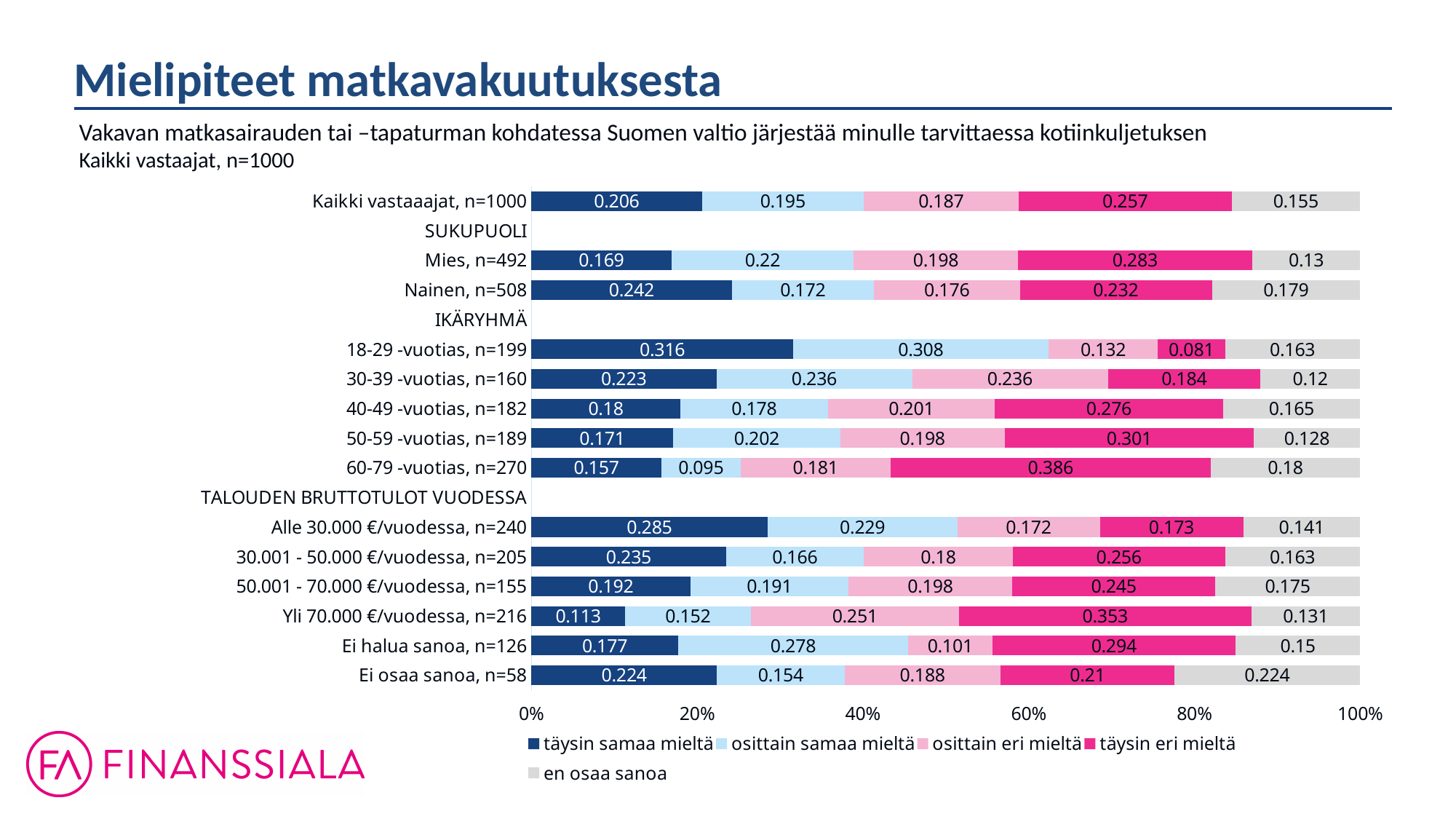
What is the 'osittain eri mieltä' value for Yli 70.000 €/vuodessa, n=216? 0.251 Which category has the highest 'täysin samaa mieltä' value? 18-29 -vuotias, n=199 What is the 'täysin samaa mieltä' value for Kaikki vastaaajat, n=1000? 0.206 What is the 'täysin eri mieltä' value for Mies, n=492? 0.283 Which category has the lowest 'täysin samaa mieltä' value? Yli 70.000 €/vuodessa, n=216 How many series does the legend list? 5 What is the difference between the 'täysin eri mieltä' values for Mies, n=492 and Nainen, n=508? 0.051 Which category has the highest 'täysin eri mieltä' value? 60-79 -vuotias, n=270 What kind of chart is shown on the slide? stacked bar chart What is the title of the slide? Mielipiteet matkavakuutuksesta What is the 'en osaa sanoa' value for Ei osaa sanoa, n=58? 0.224 Which has the larger 'osittain samaa mieltä' value: 18-29 -vuotias, n=199 or 60-79 -vuotias, n=270? 18-29 -vuotias, n=199